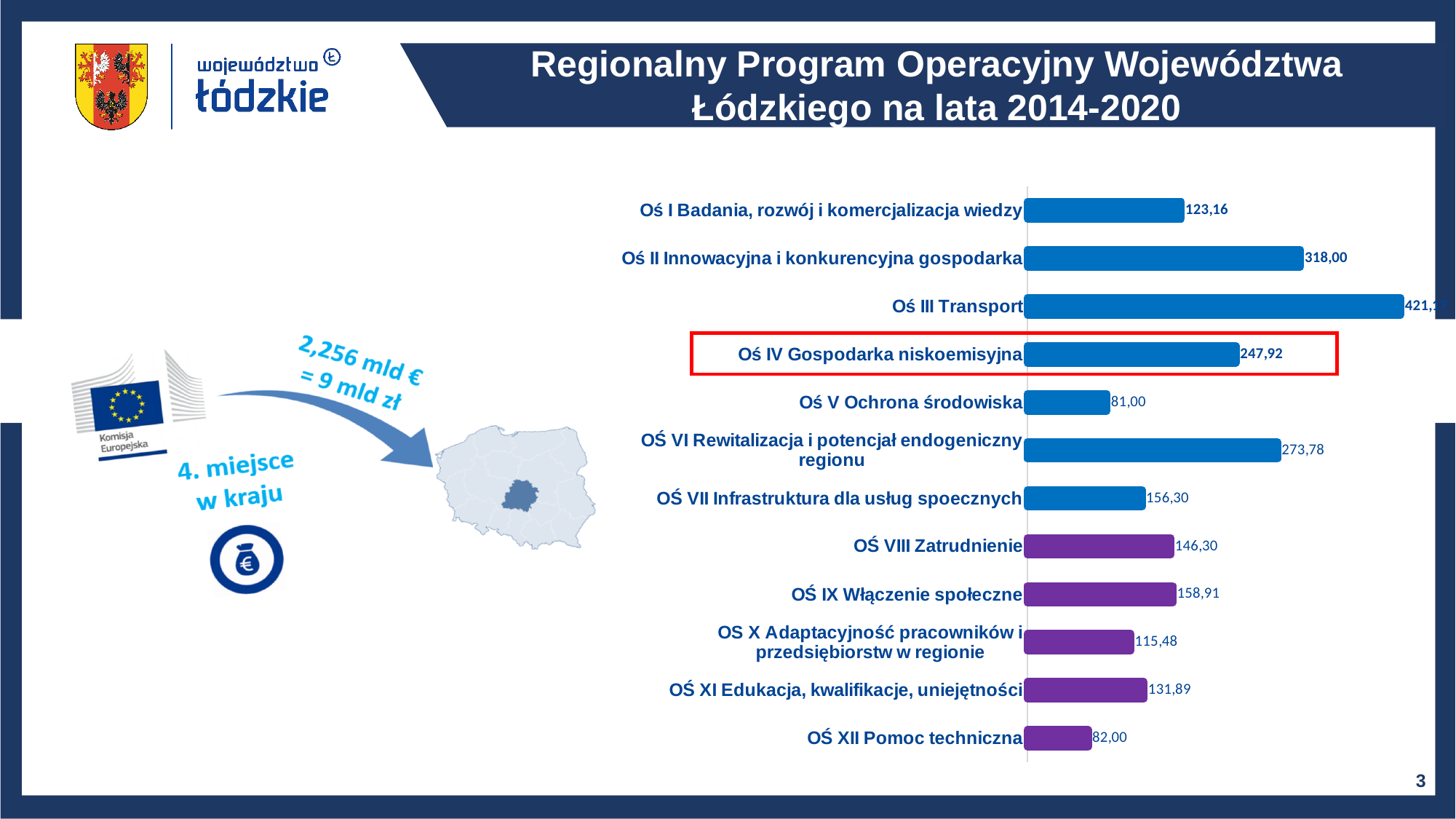
What is the value shown for OS X Adaptacyjność pracowników i przedsiębiorstw w regionie? 115,48 What is the difference between the values for Oś IV Gospodarka niskoemisyjna and Oś V Ochrona środowiska? 166,92 What is the value shown for OŚ VI Rewitalizacja i potencjał endogeniczny regionu? 273,78 What is the value shown for OŚ XII Pomoc techniczna? 82,00 Which has a larger value: Oś II Innowacyjna i konkurencyjna gospodarka or OŚ VI Rewitalizacja i potencjał endogeniczny regionu? Oś II Innowacyjna i konkurencyjna gospodarka How many categories are shown in the chart? 12 What is the value shown for Oś I Badania, rozwój i komercjalizacja wiedzy? 123,16 What is the value shown for Oś IV Gospodarka niskoemisyjna? 247,92 What kind of chart is shown on the slide? Bar chart What is the difference between the values for Oś II Innowacyjna i konkurencyjna gospodarka and Oś I Badania, rozwój i komercjalizacja wiedzy? 194,84 Which category has the highest value in the chart? Oś III Transport Which category in the chart is highlighted with a red box? Oś IV Gospodarka niskoemisyjna